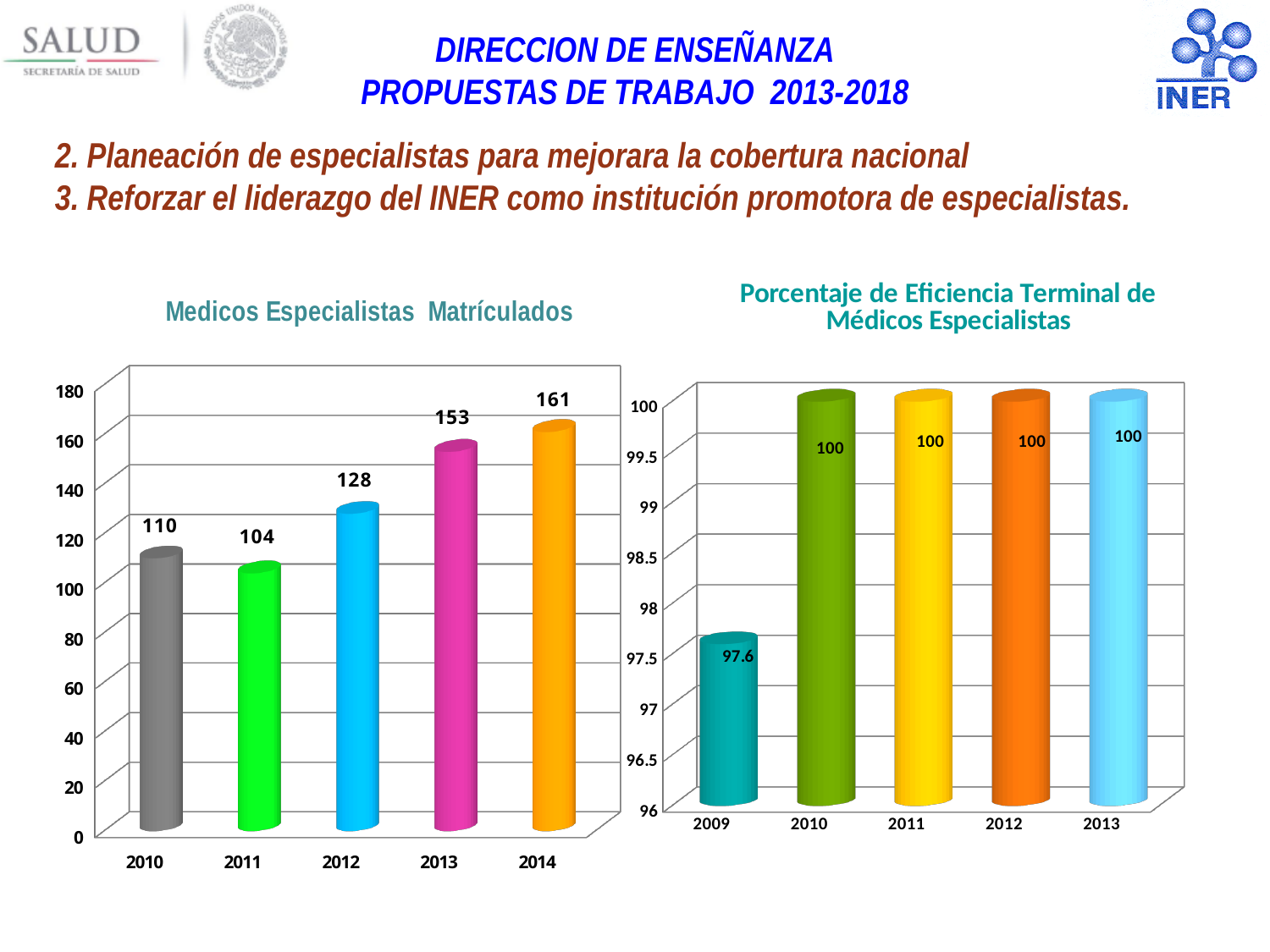
What kind of chart is the 'Medicos Especialistas Matrículados' chart? Bar chart How many years are shown in the 'Porcentaje de Eficiencia Terminal de Médicos Especialistas' chart? 5 How many years are shown in the 'Medicos Especialistas Matrículados' chart? 5 In the 'Porcentaje de Eficiencia Terminal de Médicos Especialistas' chart, what is the value for 2009? 97.6 In the 'Porcentaje de Eficiencia Terminal de Médicos Especialistas' chart, which year has the lowest value? 2009 In the 'Medicos Especialistas Matrículados' chart, what is the value for 2012? 128 In the 'Medicos Especialistas Matrículados' chart, what is the difference between the values for 2014 and 2010? 51 In the 'Medicos Especialistas Matrículados' chart, which is larger, the value for 2013 or the value for 2012? 2013 In the 'Medicos Especialistas Matrículados' chart, which year has the highest value? 2014 In the 'Medicos Especialistas Matrículados' chart, which year has the lowest value? 2011 In the 'Porcentaje de Eficiencia Terminal de Médicos Especialistas' chart, what is the difference between the values for 2010 and 2009? 2.4 In the 'Medicos Especialistas Matrículados' chart, what colour is the bar for 2014? Orange